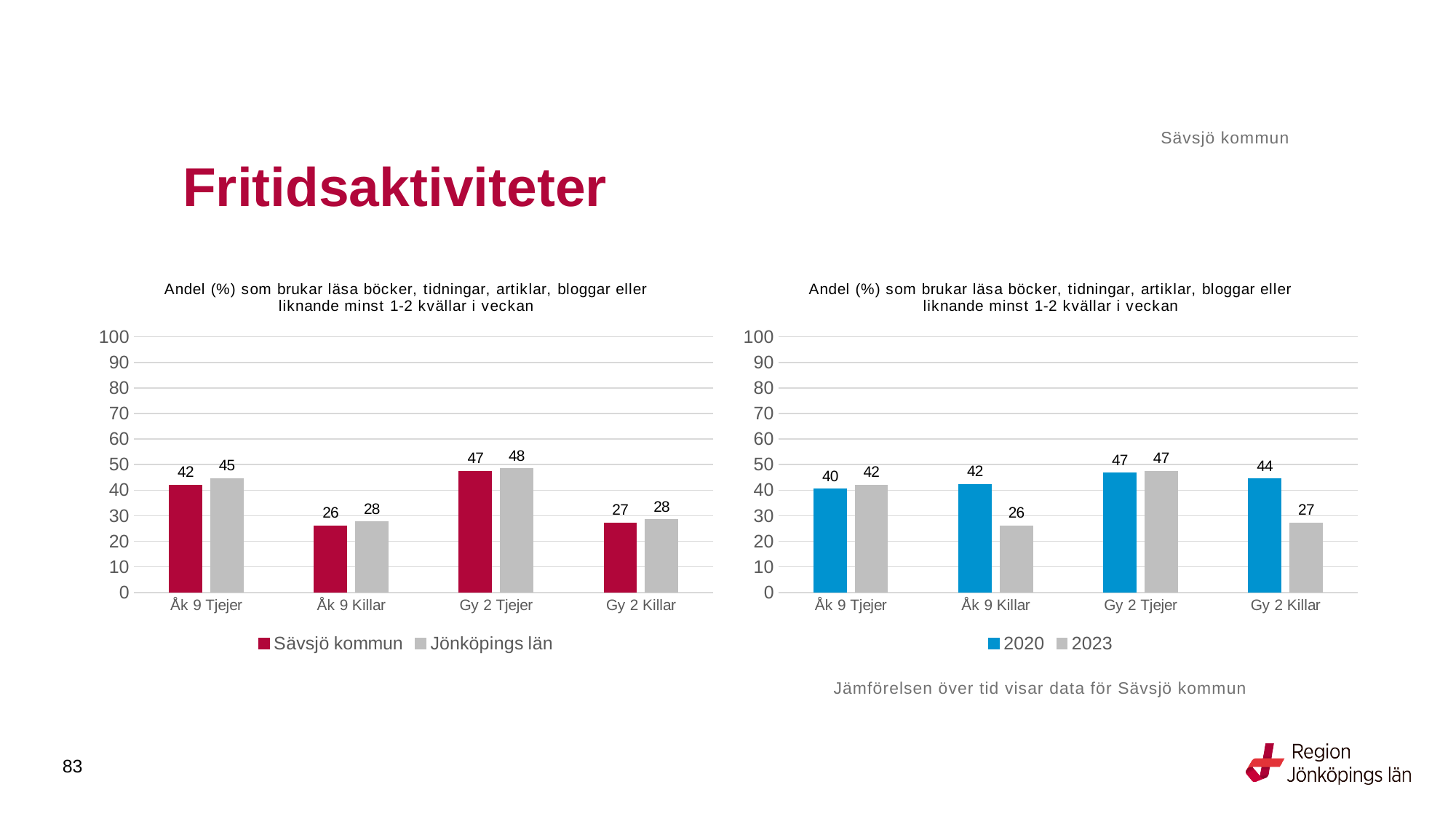
How many series does the legend of the right chart list? 2 In the left chart, what is the difference between Jönköpings län and Sävsjö kommun for Åk 9 Tjejer? 3 In the left chart, which category has the highest value for Sävsjö kommun? Gy 2 Tjejer In the right chart, which is larger for Åk 9 Tjejer: the 2020 value or the 2023 value? 2023 In the left chart, what is the value for Jönköpings län for Gy 2 Killar? 28 How many categories are shown on the x axis of the left chart? 4 In the right chart, what is the difference between the 2020 and 2023 values for Gy 2 Killar? 17 In the right chart, what is the value for 2020 for Gy 2 Killar? 44 In the right chart, which category has the lowest value for 2023? Åk 9 Killar In the right chart, what is the value for 2023 for Åk 9 Killar? 26 In the left chart, what is the value for Sävsjö kommun for Åk 9 Tjejer? 42 What type of chart is the left chart? Bar chart